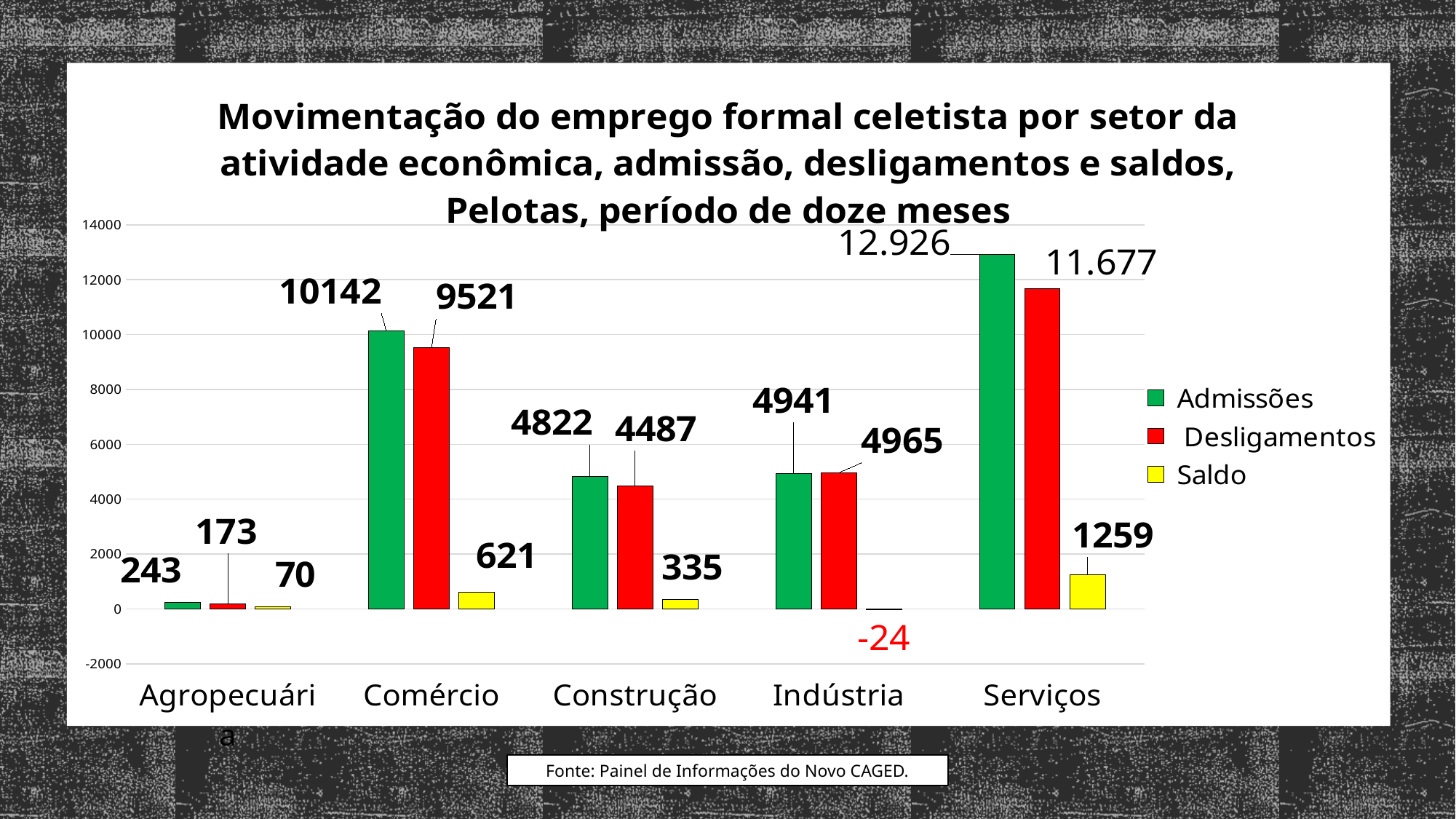
What is the Admissões value for Comércio? 10142 What is the Desligamentos value for Serviços? 11.677 How many series does the legend list? 3 What is the difference between Admissões and Desligamentos for Construção? 335 Which sector has the highest Admissões value? Serviços What is the Saldo value for Indústria? -24 What is the Saldo value for Agropecuária? 70 What kind of chart is shown on the slide? Bar chart Which sector has the lowest Saldo value? Indústria How many sectors are shown on the x axis? 5 Is the Admissões value for Serviços greater or less than 12000? greater Which is larger for Indústria, Admissões or Desligamentos? Desligamentos